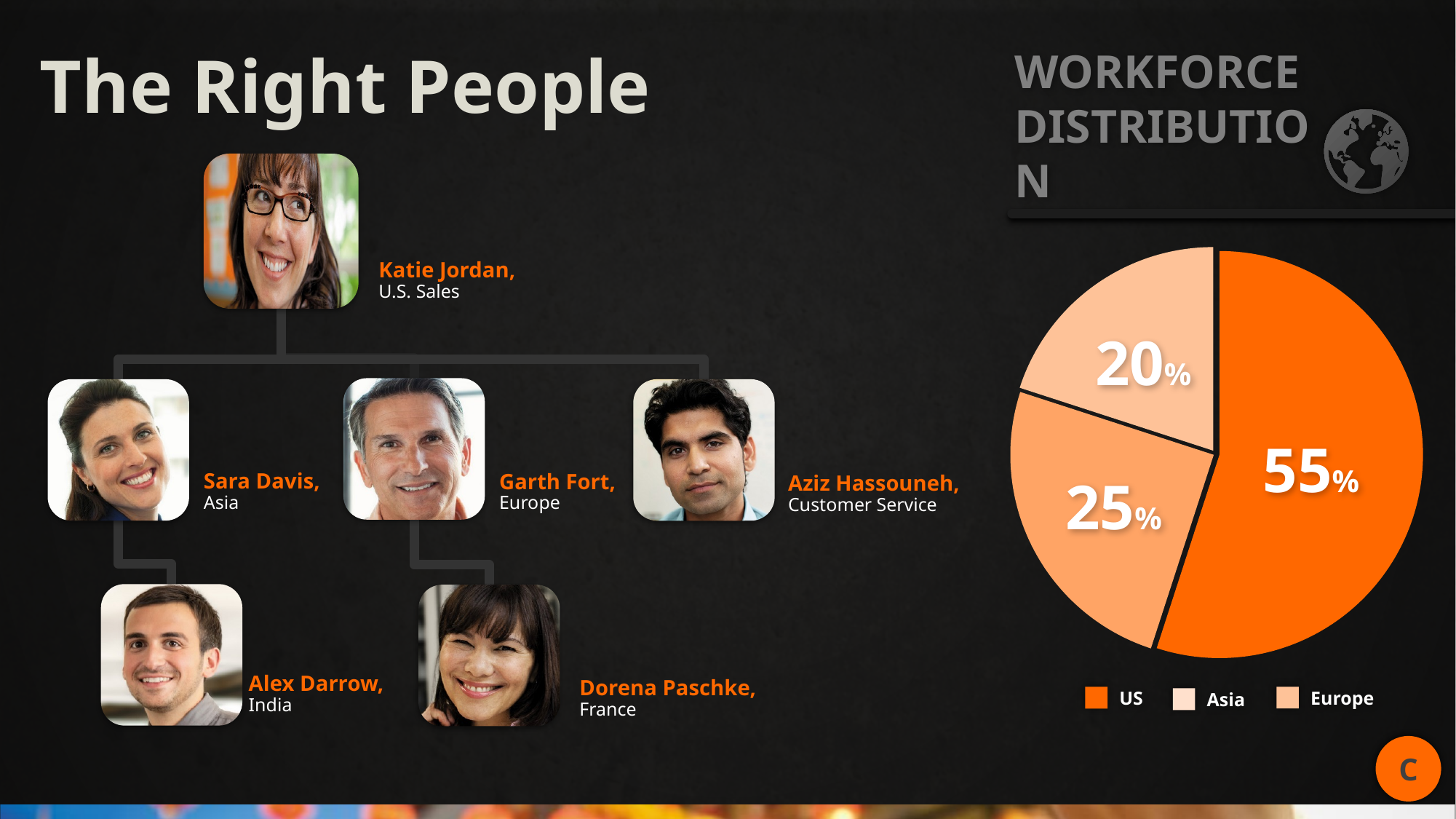
What share of the workforce is in the US according to the pie chart? 55% Which region is represented by the darkest orange slice in the pie chart? US What share of the workforce is in Asia according to the pie chart? 20% What type of chart is used to show the workforce distribution? Pie chart Which region has the largest share of the workforce in the pie chart? US How many percentage points larger is the US share than the Europe share? 30 Which has a larger share of the workforce, Europe or Asia? Europe Which region has the smallest share of the workforce in the pie chart? Asia What is the title of the chart on the right of the slide? WORKFORCE DISTRIBUTION How many regions are shown in the pie chart? 3 What share of the workforce is in Europe according to the pie chart? 25% What is the difference between the Europe share and the Asia share? 5%